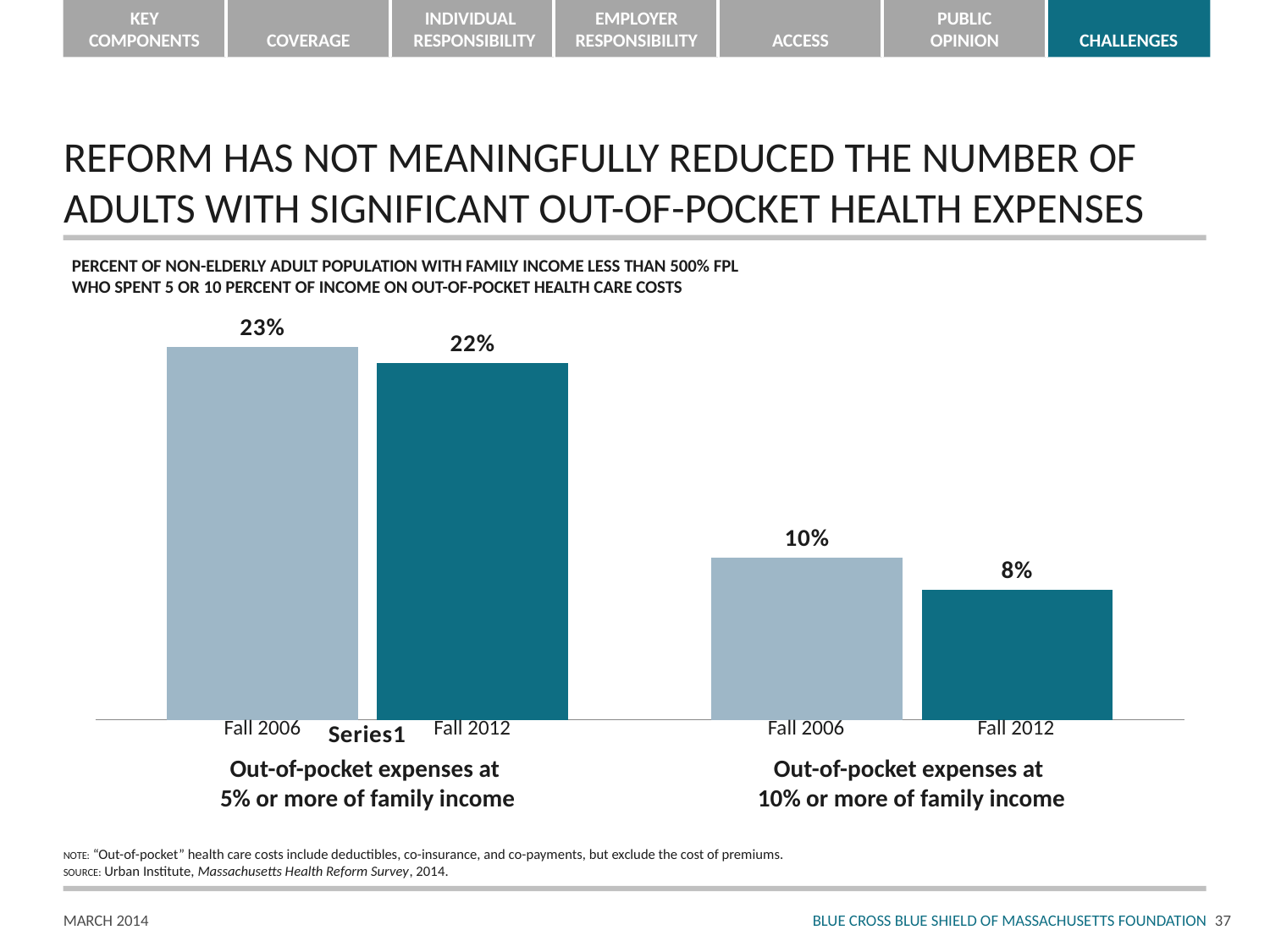
What percentage of non-elderly adults spent 10% or more of family income on out-of-pocket health care costs in Fall 2006? 10% How many bars are plotted in the chart? 4 What is the difference between the Fall 2006 and Fall 2012 values for out-of-pocket expenses at 5% or more of family income? 1 percentage point Which bar in the chart has the highest value? Fall 2006, out-of-pocket expenses at 5% or more of family income What type of chart is shown on the slide? Bar chart From Fall 2006 to Fall 2012, did the share of adults with out-of-pocket expenses at 5% or more of family income rise or fall? Fall Which bar in the chart has the lowest value? Fall 2012, out-of-pocket expenses at 10% or more of family income By how many percentage points did the share of adults with out-of-pocket expenses at 10% or more of family income change from Fall 2006 to Fall 2012? 2 percentage points For out-of-pocket expenses at 10% or more of family income, which is larger: the Fall 2006 value or the Fall 2012 value? Fall 2006 What percentage of non-elderly adults spent 5% or more of family income on out-of-pocket health care costs in Fall 2012? 22% What percentage of non-elderly adults spent 10% or more of family income on out-of-pocket health care costs in Fall 2012? 8% What percentage of non-elderly adults spent 5% or more of family income on out-of-pocket health care costs in Fall 2006? 23%